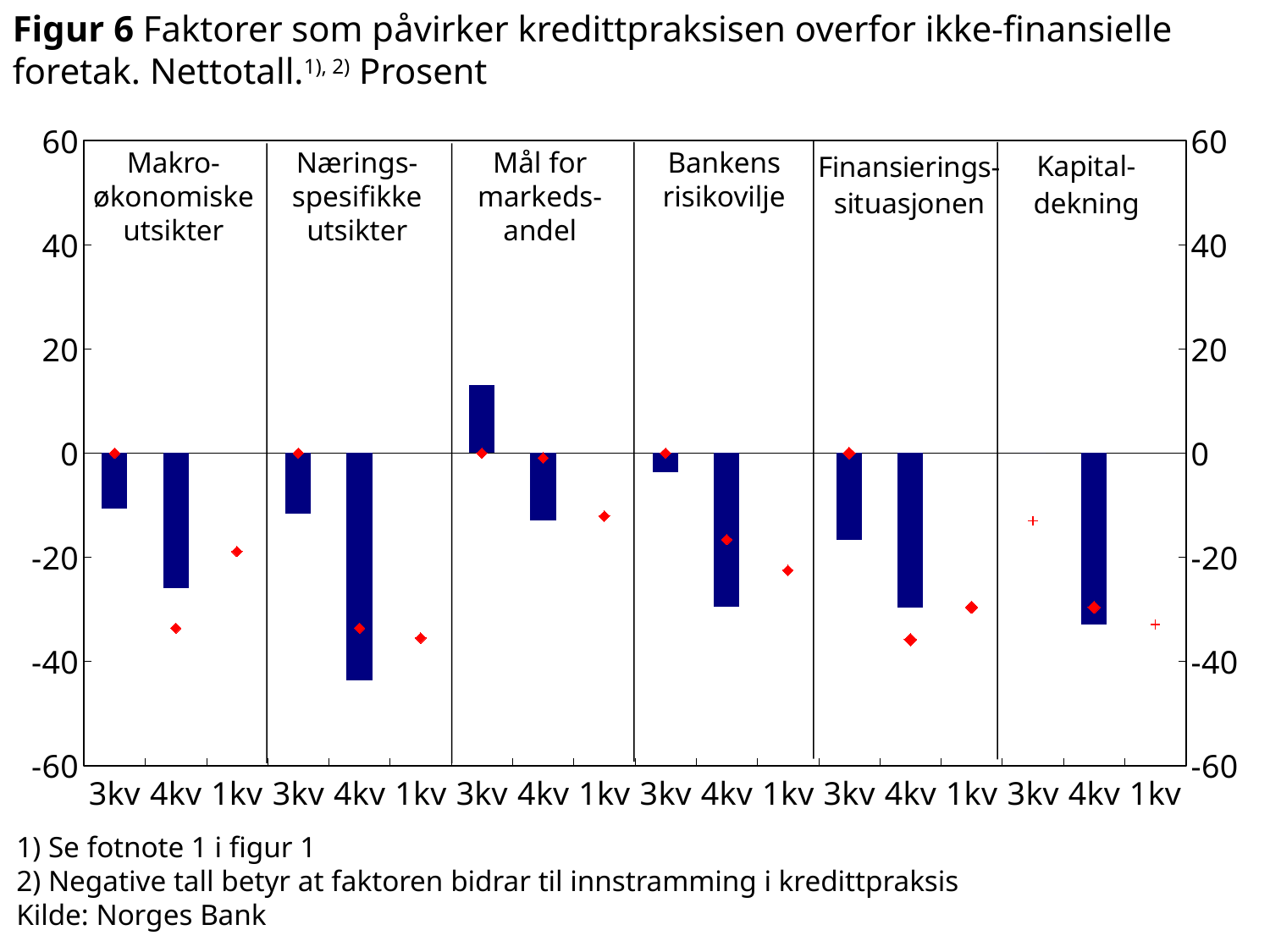
What are the minimum and maximum values shown on the y axis? -60 and 60 How many factors (panels) are shown along the x axis of the chart? 6 Which factor has the lowest 4kv bar? Næringsspesifikke utsikter Is the 4kv bar for Bankens risikovilje greater or less than -20? less Is the 3kv bar for Mål for markedsandel greater or less than 20? less What kind of chart is shown in Figur 6? combination bar and line chart (bars with point markers) Is the 4kv bar for Næringsspesifikke utsikter greater or less than -40? less For Makroøkonomiske utsikter, does the bar value rise or fall from 3kv to 4kv? fall Which factor has the only bar with a positive value? Mål for markedsandel What is the source given for the chart? Norges Bank Which has the lower 3kv bar: Bankens risikovilje or Finansieringssituasjonen? Finansieringssituasjonen